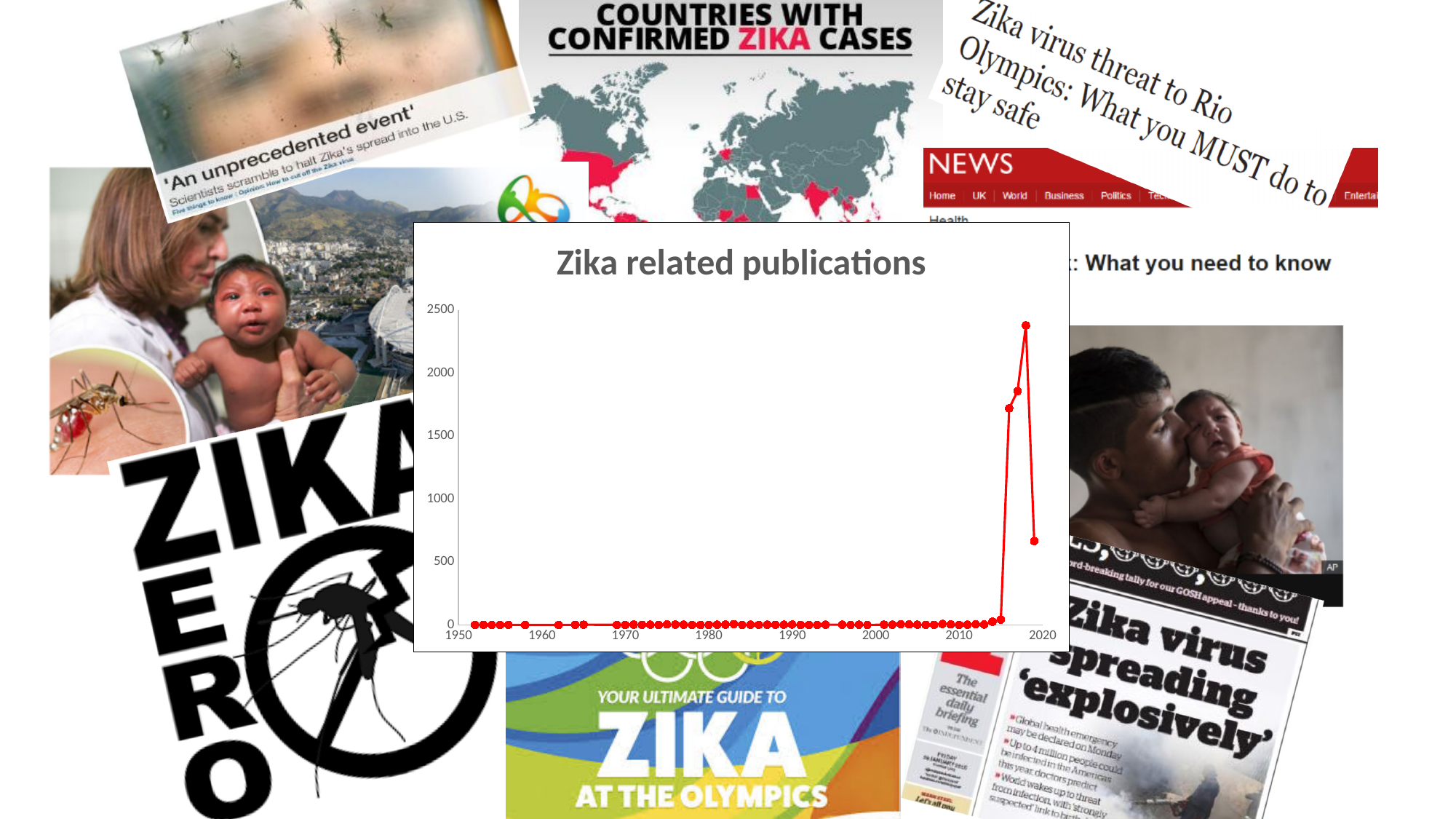
Is the highest value on the chart greater or less than 2500? less Overall, do the values rise or fall from 1950 to the peak after 2010? rise Is the highest value on the chart greater or less than 2000? greater Is the value of the last point on the chart greater or less than 1000? less What is the title of the chart? Zika related publications In which decade does the sharp rise in publications occur? 2010s What kind of chart is shown on the slide? line chart What is the highest value shown on the y axis of the chart? 2500 Which is larger, the value for 1990 or the highest value after 2010? the highest value after 2010 After the peak, does the line rise or fall at the last point? fall